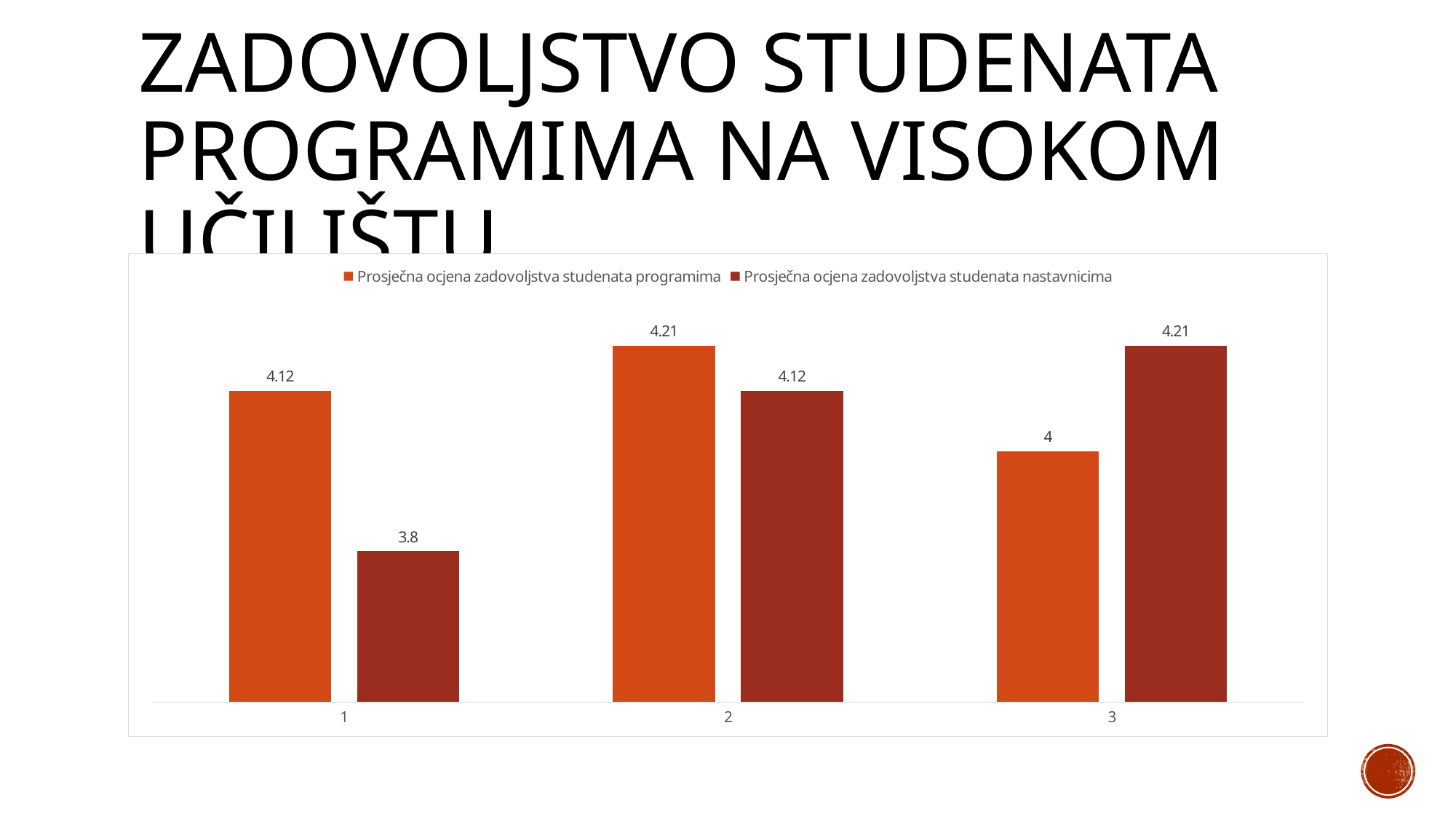
How many categories are shown on the x axis? 3 Which category has the lowest value for 'Prosječna ocjena zadovoljstva studenata nastavnicima'? 1 What is the value of 'Prosječna ocjena zadovoljstva studenata programima' for category 1? 4.12 What is the value of 'Prosječna ocjena zadovoljstva studenata nastavnicima' for category 1? 3.8 What is the difference between the 'Prosječna ocjena zadovoljstva studenata programima' values for category 2 and category 3? 0.21 For category 3, which series has the larger value? Prosječna ocjena zadovoljstva studenata nastavnicima What is the value of 'Prosječna ocjena zadovoljstva studenata nastavnicima' for category 3? 4.21 Which category has the highest value for 'Prosječna ocjena zadovoljstva studenata programima'? 2 What kind of chart is shown on the slide? Bar chart What is the value of 'Prosječna ocjena zadovoljstva studenata programima' for category 3? 4 How many series does the legend list? 2 What is the difference between the two series' values for category 1? 0.32